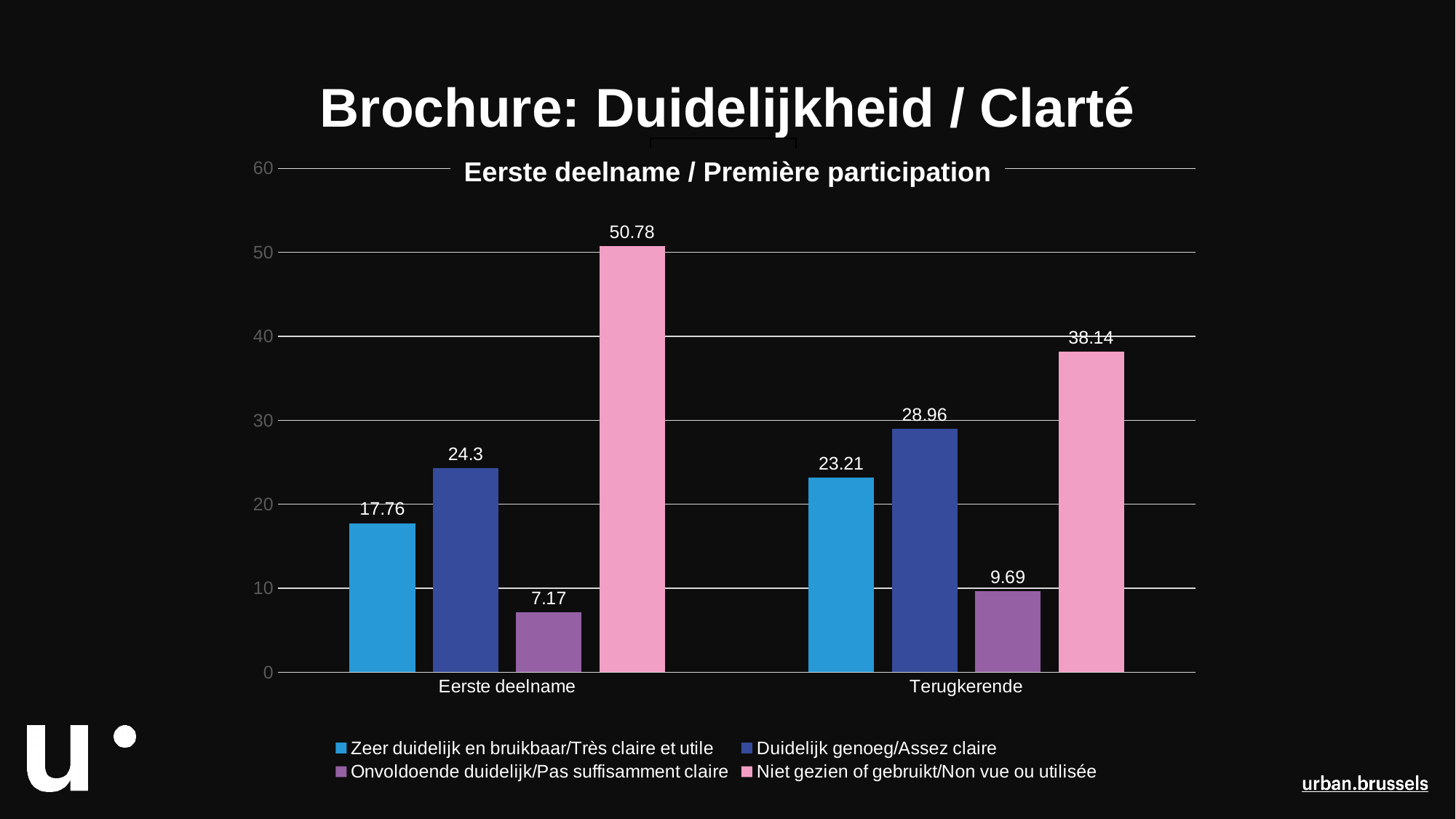
Which is larger: "Zeer duidelijk en bruikbaar/Très claire et utile" for Eerste deelname or for Terugkerende? Terugkerende What kind of chart is shown on the slide? Bar chart Is the value for "Duidelijk genoeg/Assez claire" in the Eerste deelname group greater or less than 20? greater Which series has the highest value in the Terugkerende group? Niet gezien of gebruikt/Non vue ou utilisée What is the value for "Niet gezien of gebruikt/Non vue ou utilisée" in the Eerste deelname group? 50.78 What is the value for "Duidelijk genoeg/Assez claire" in the Terugkerende group? 28.96 What is the value for "Onvoldoende duidelijk/Pas suffisamment claire" in the Eerste deelname group? 7.17 What is the value for "Zeer duidelijk en bruikbaar/Très claire et utile" in the Terugkerende group? 23.21 How many categories are shown on the x axis? 2 What is the difference between the "Niet gezien of gebruikt/Non vue ou utilisée" values for Eerste deelname and Terugkerende? 12.64 Which series has the lowest value in the Eerste deelname group? Onvoldoende duidelijk/Pas suffisamment claire How many series does the legend list? 4